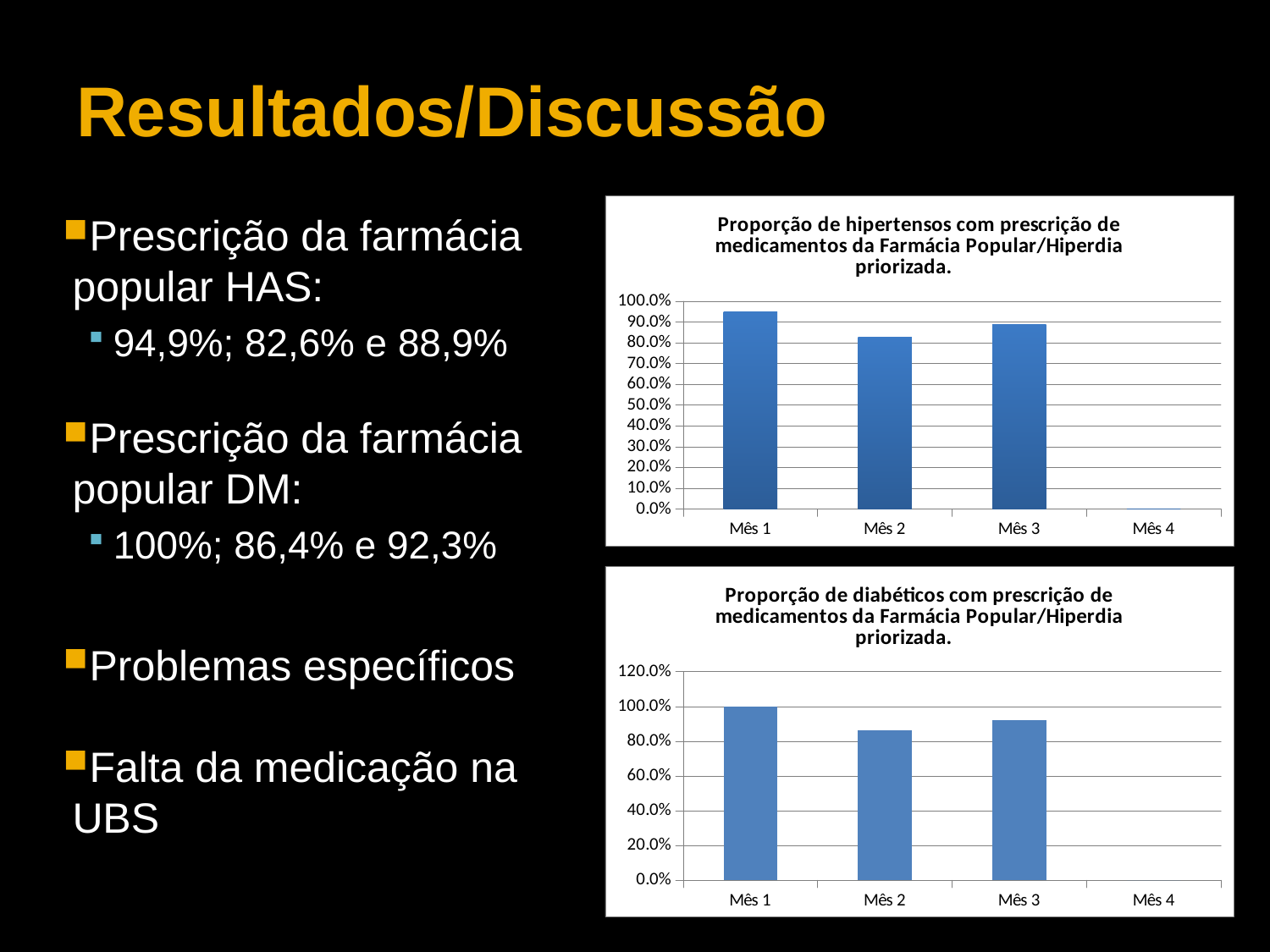
In the bottom chart (diabéticos), is the value for Mês 3 greater or less than 80.0%? greater In the top chart (hipertensos), is the value for Mês 1 greater or less than 90.0%? greater In the top chart (hipertensos), which is larger, the value for Mês 2 or the value for Mês 3? Mês 3 In the top chart (hipertensos), is the value for Mês 2 greater or less than 90.0%? less In the top chart (hipertensos), what is the highest value shown on the vertical axis? 100.0% In the top chart (hipertensos), which month has the highest bar? Mês 1 What kind of chart is the top chart, 'Proporção de hipertensos com prescrição de medicamentos da Farmácia Popular/Hiperdia priorizada'? Bar chart In the top chart (hipertensos), which month has the lowest plotted bar? Mês 2 In the bottom chart (diabéticos), how many bars are plotted? 3 In the bottom chart (diabéticos), which is larger, the value for Mês 1 or the value for Mês 2? Mês 1 In the bottom chart (diabéticos), what is the value for Mês 1? 100.0% In the bottom chart (diabéticos), which month has the lowest plotted bar? Mês 2